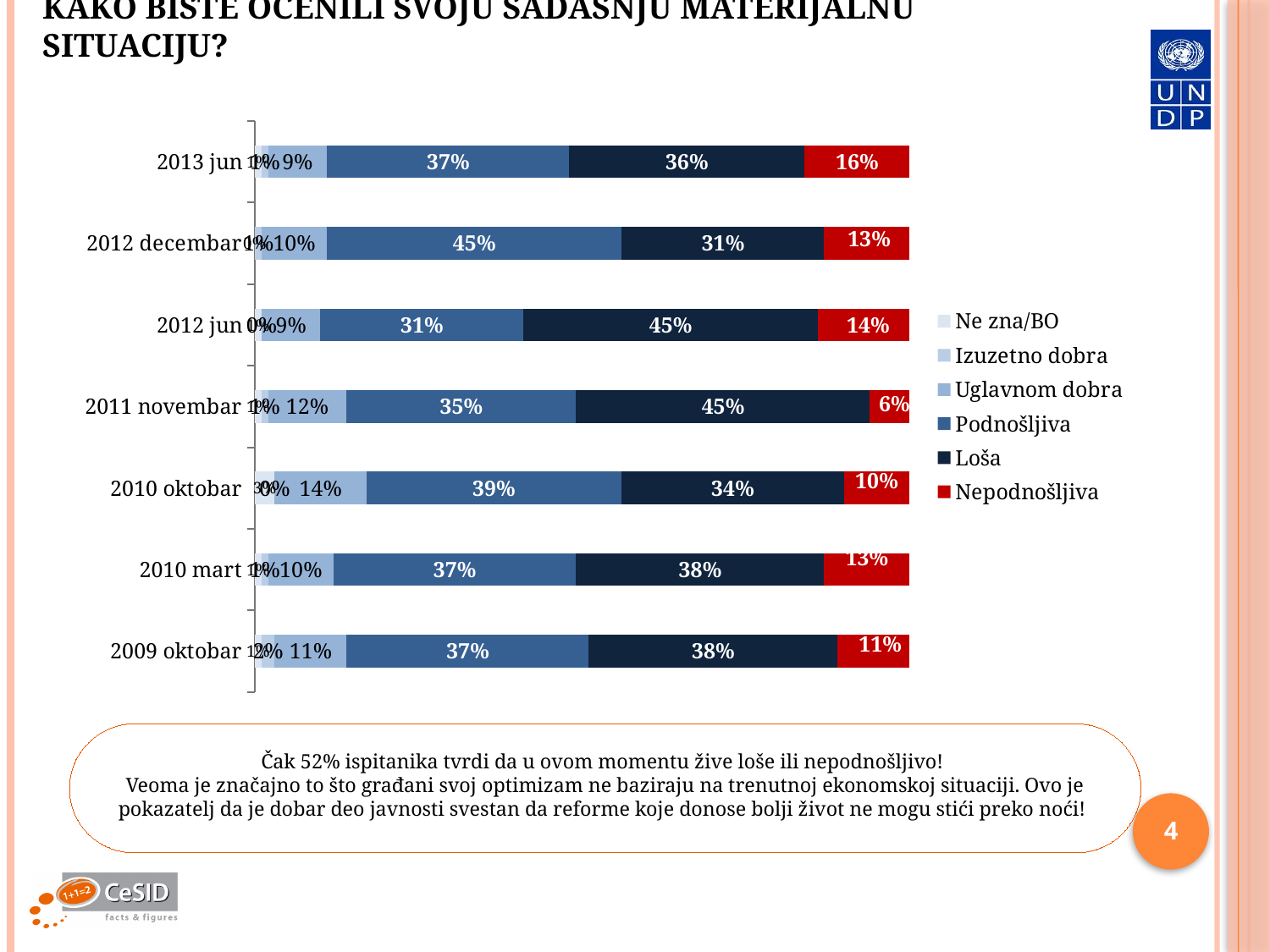
What is the value for Nepodnošljiva in 2011 novembar? 6% Which is larger in 2010 mart: the Podnošljiva value or the Loša value? Loša What is the value for Uglavnom dobra in 2010 oktobar? 14% What kind of chart is shown on the slide? stacked bar chart In which survey wave is the Nepodnošljiva value lowest? 2011 novembar What is the difference between the Podnošljiva values in 2012 decembar and 2012 jun? 14% What is the value for Loša in 2013 jun? 36% How many series does the legend list? 6 What is the value for Podnošljiva in 2012 decembar? 45% Which legend entry is shown in red? Nepodnošljiva In which survey wave is the Nepodnošljiva value highest? 2013 jun How many survey waves (categories) are shown on the chart? 7